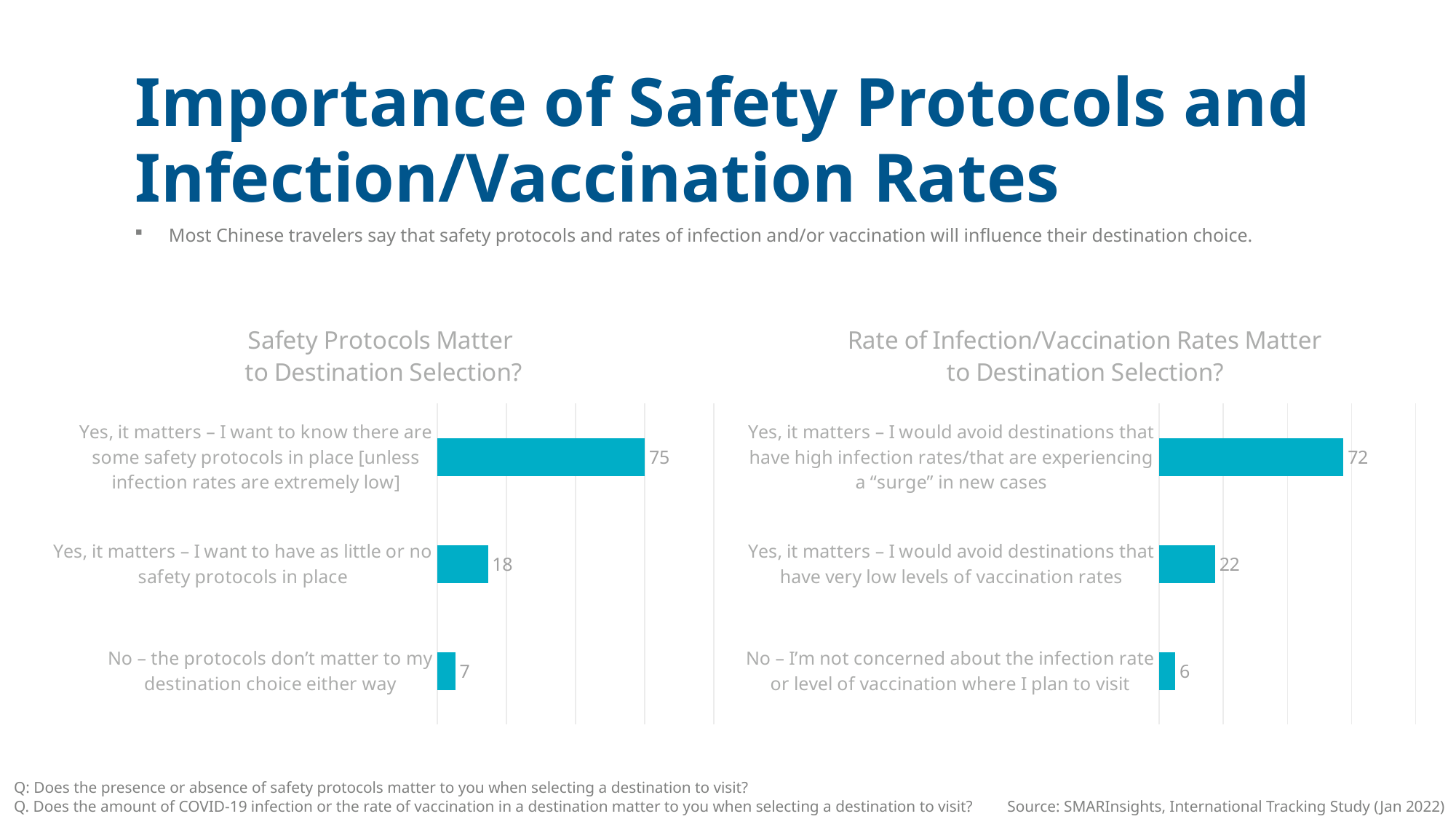
In the 'Safety Protocols Matter to Destination Selection?' chart, what is the value for 'Yes, it matters – I want to know there are some safety protocols in place'? 75 How many categories are shown in the 'Rate of Infection/Vaccination Rates Matter to Destination Selection?' chart? 3 In the 'Safety Protocols Matter to Destination Selection?' chart, which category has the lowest value? No – the protocols don't matter to my destination choice either way In the 'Rate of Infection/Vaccination Rates Matter to Destination Selection?' chart, what is the total of the three values shown? 100 In the 'Rate of Infection/Vaccination Rates Matter to Destination Selection?' chart, what is the difference between the values for the two 'Yes, it matters' categories? 50 In the 'Safety Protocols Matter to Destination Selection?' chart, what is the difference between the values for 'Yes, it matters – I want to know there are some safety protocols in place' and 'Yes, it matters – I want to have as little or no safety protocols in place'? 57 How many charts are shown on the slide? 2 In the 'Safety Protocols Matter to Destination Selection?' chart, what is the value for 'No – the protocols don't matter to my destination choice either way'? 7 What type of chart is the 'Safety Protocols Matter to Destination Selection?' chart? Bar chart In the 'Rate of Infection/Vaccination Rates Matter to Destination Selection?' chart, which category has the highest value? Yes, it matters – I would avoid destinations that have high infection rates/that are experiencing a "surge" in new cases Which is larger: the 'No' value in the 'Safety Protocols Matter' chart or the 'No' value in the 'Rate of Infection/Vaccination Rates Matter' chart? Safety Protocols Matter (7) In the 'Rate of Infection/Vaccination Rates Matter to Destination Selection?' chart, what is the value for 'Yes, it matters – I would avoid destinations that have very low levels of vaccination rates'? 22